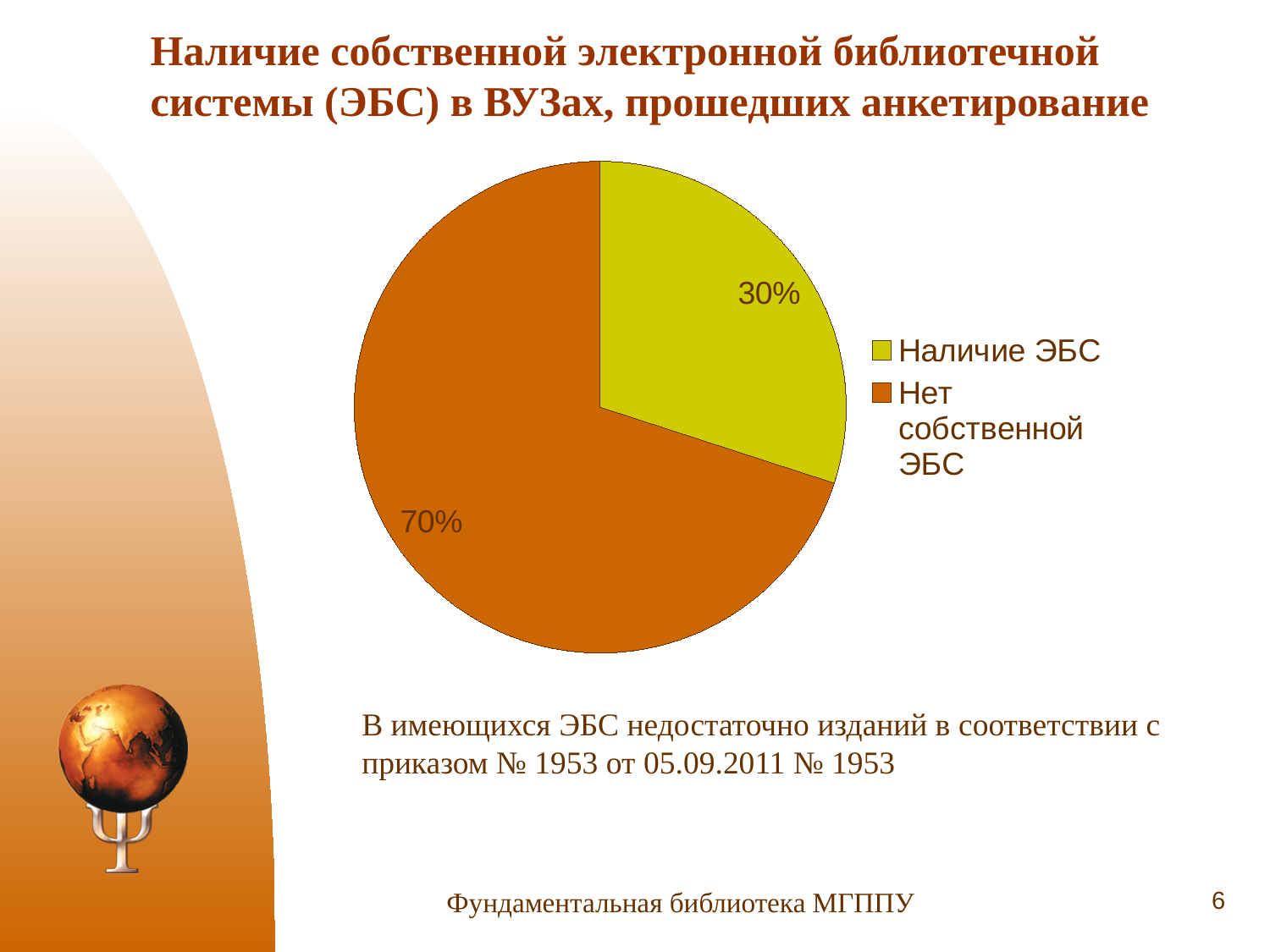
How many slices does the pie chart have? 2 What share of the pie does "Наличие ЭБС" represent? 30% Which is larger: the slice for "Наличие ЭБС" or the slice for "Нет собственной ЭБС"? Нет собственной ЭБС Which category has the smallest slice of the pie? Наличие ЭБС What colour is the slice for "Нет собственной ЭБС"? orange How many entries does the legend list? 2 Which category has the largest slice of the pie? Нет собственной ЭБС What share of the pie does "Нет собственной ЭБС" represent? 70% What is the difference in percentage points between "Нет собственной ЭБС" and "Наличие ЭБС"? 40% What kind of chart is shown on the slide? pie chart What colour is the slice for "Наличие ЭБС"? yellow-green